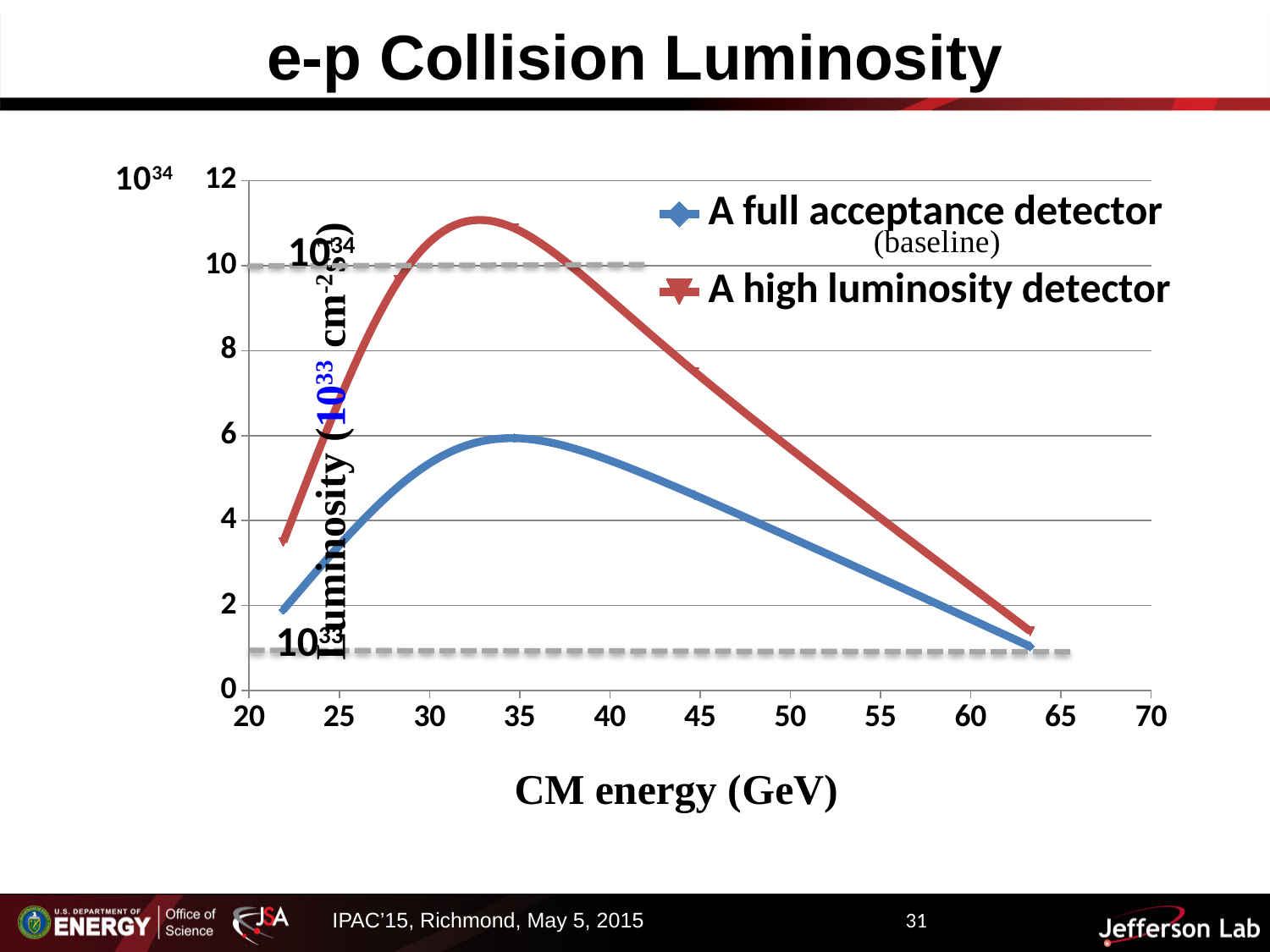
Which series reaches the higher peak luminosity? A high luminosity detector Does the high luminosity detector curve rise or fall between 35 GeV and 60 GeV? fall At 45 GeV, which series has the higher luminosity? A high luminosity detector Does the full acceptance detector curve rise or fall between 22 GeV and 35 GeV? rise Is the value of the high luminosity detector curve at 45 GeV greater or less than 6? greater Is the peak value of the full acceptance detector curve greater or less than 8? less What kind of chart is shown on the slide? line chart How many series does the legend list? 2 Is the value of the full acceptance detector curve at 55 GeV greater or less than 4? less Which series is drawn in red? A high luminosity detector What is the title of the x axis? CM energy (GeV)